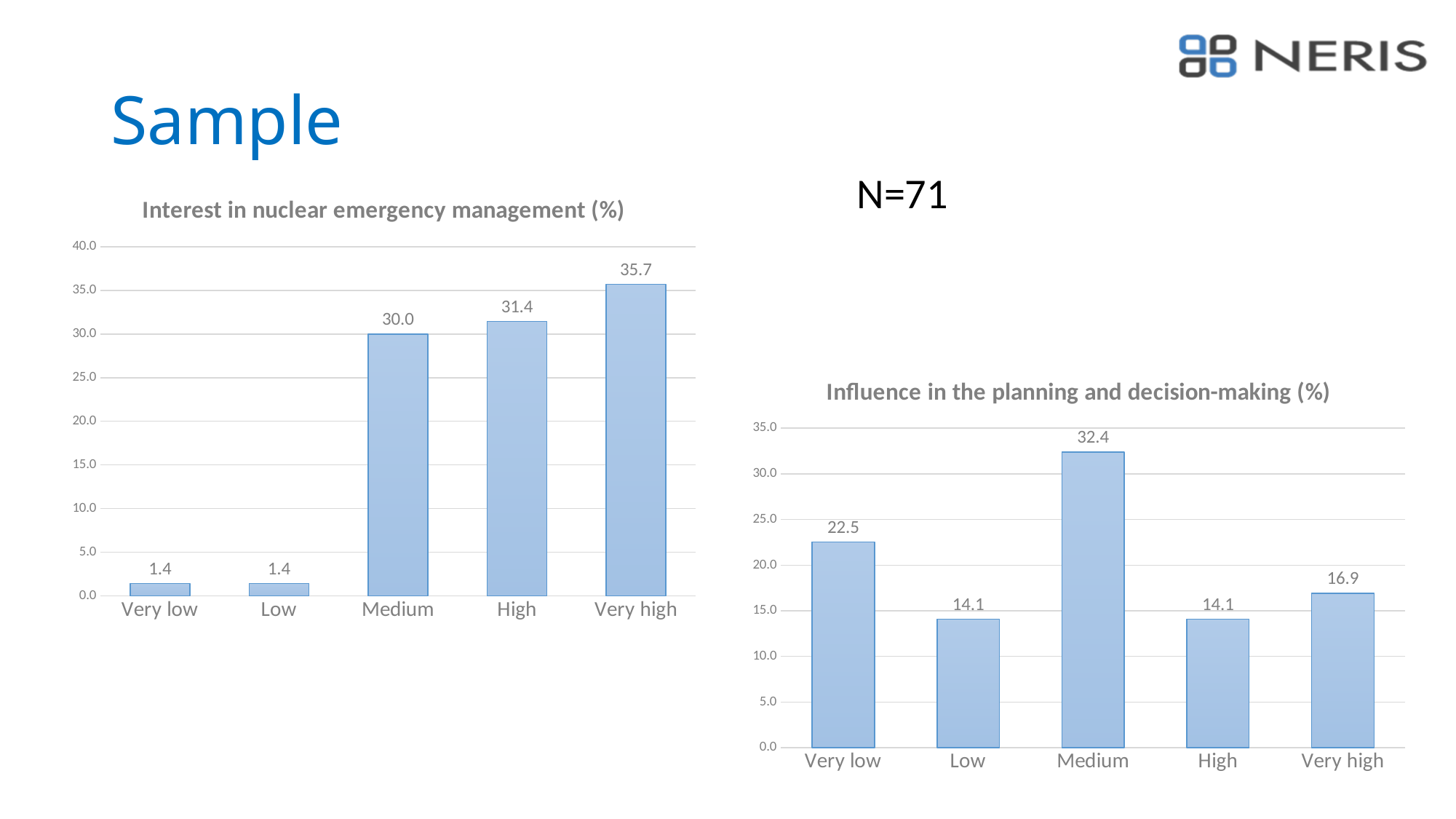
In the 'Interest in nuclear emergency management (%)' chart, what is the difference between the values for Very high and High? 4.3 In the 'Influence in the planning and decision-making (%)' chart, which category has the highest value? Medium What is the title of the chart on the right side of the slide? Influence in the planning and decision-making (%) In the 'Influence in the planning and decision-making (%)' chart, is the value for Medium greater or less than 30.0? greater In the 'Interest in nuclear emergency management (%)' chart, what is the value for Medium? 30.0 What kind of chart is the 'Interest in nuclear emergency management (%)' chart? bar chart In the 'Influence in the planning and decision-making (%)' chart, what is the value for Very low? 22.5 In the 'Influence in the planning and decision-making (%)' chart, which is larger, the value for Very low or the value for Very high? Very low In the 'Interest in nuclear emergency management (%)' chart, what is the value for Very high? 35.7 In the 'Interest in nuclear emergency management (%)' chart, which category has the highest value? Very high In the 'Interest in nuclear emergency management (%)' chart, how many categories are shown on the x axis? 5 In the 'Influence in the planning and decision-making (%)' chart, what is the difference between the values for Medium and Very high? 15.5